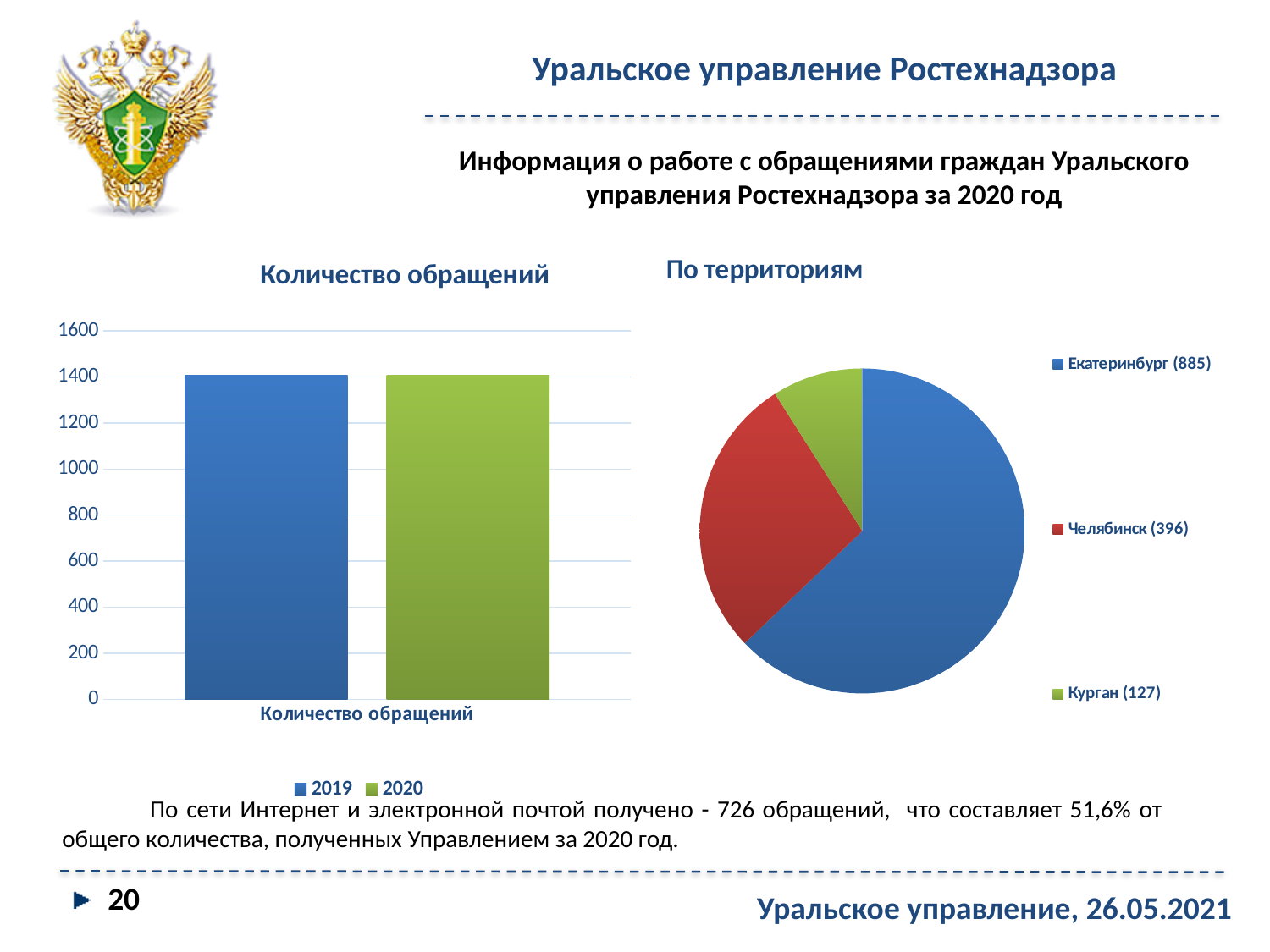
In the 'По территориям' pie chart, how many slices are there? 3 In the 'По территориям' pie chart, what is the difference between the values for Екатеринбург and Челябинск? 489 In the 'Количество обращений' bar chart, is the value for 2019 greater or less than 1200? greater In the 'Количество обращений' bar chart, how many series does the legend list? 2 In the 'По территориям' pie chart, what is the value for Челябинск? 396 What kind of chart is the 'По территориям' chart on the right? pie chart In the 'Количество обращений' bar chart, which years are listed in the legend? 2019 and 2020 In the 'По территориям' pie chart, which territory has the largest value? Екатеринбург In the 'По территориям' pie chart, which territory has the smallest value? Курган In the 'Количество обращений' bar chart, is the value for 2020 greater or less than 1600? less What kind of chart is the 'Количество обращений' chart on the left? bar chart In the 'По территориям' pie chart, what is the value for Курган? 127